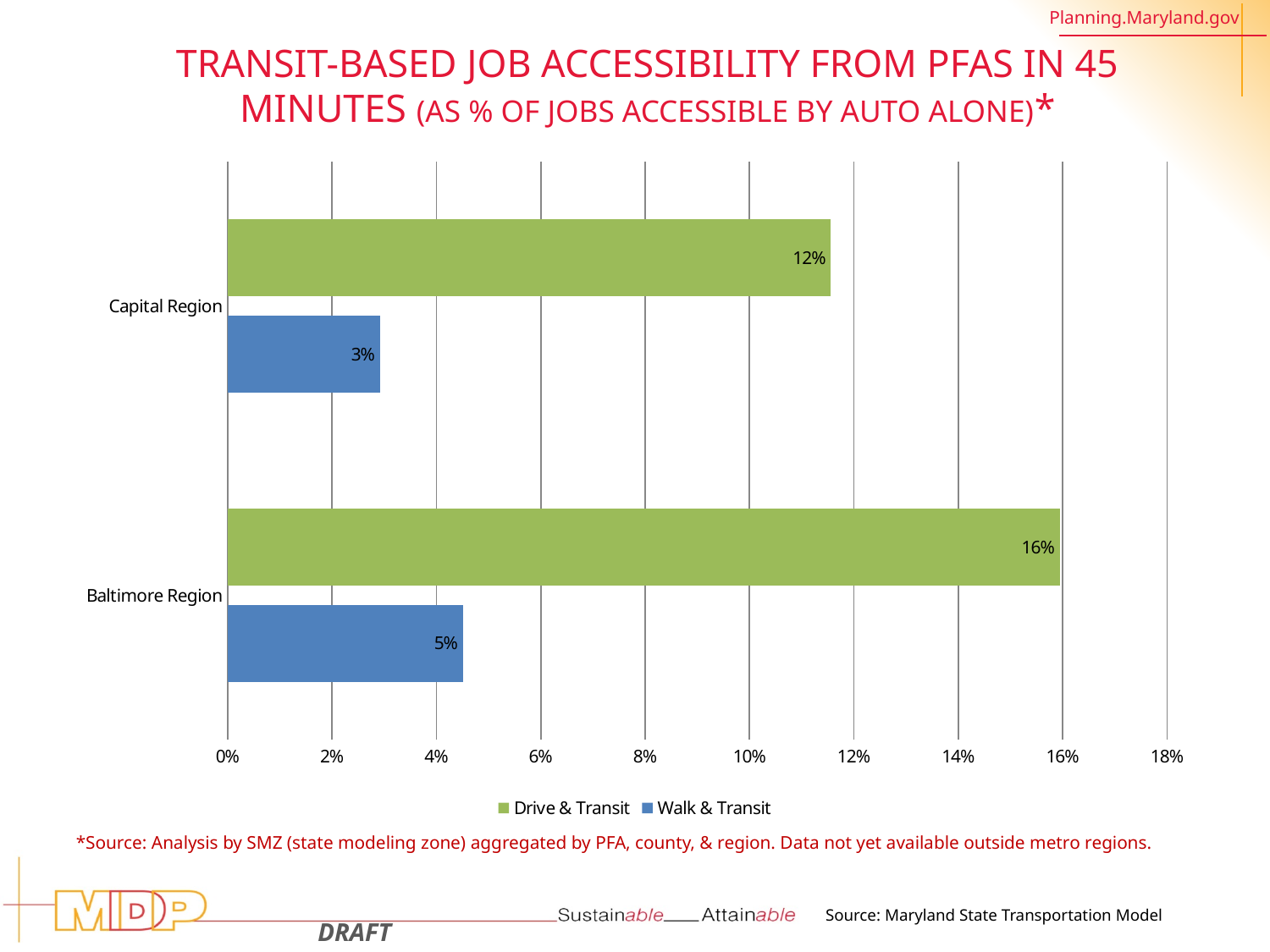
How many series does the legend list? 2 Which region has the lower Walk & Transit value? Capital Region What is the Walk & Transit value for the Baltimore Region? 5% Is the Walk & Transit value for the Baltimore Region larger or smaller than the Walk & Transit value for the Capital Region? larger What is the Walk & Transit value for the Capital Region? 3% What is the Drive & Transit value for the Baltimore Region? 16% What is the Drive & Transit value for the Capital Region? 12% Which region has the higher Drive & Transit value? Baltimore Region Is the Drive & Transit value for the Capital Region greater or less than 10%? greater What kind of chart is shown on the slide? bar chart What is the difference between the Drive & Transit values for the Baltimore Region and the Capital Region? 4% How many regions are shown on the chart? 2